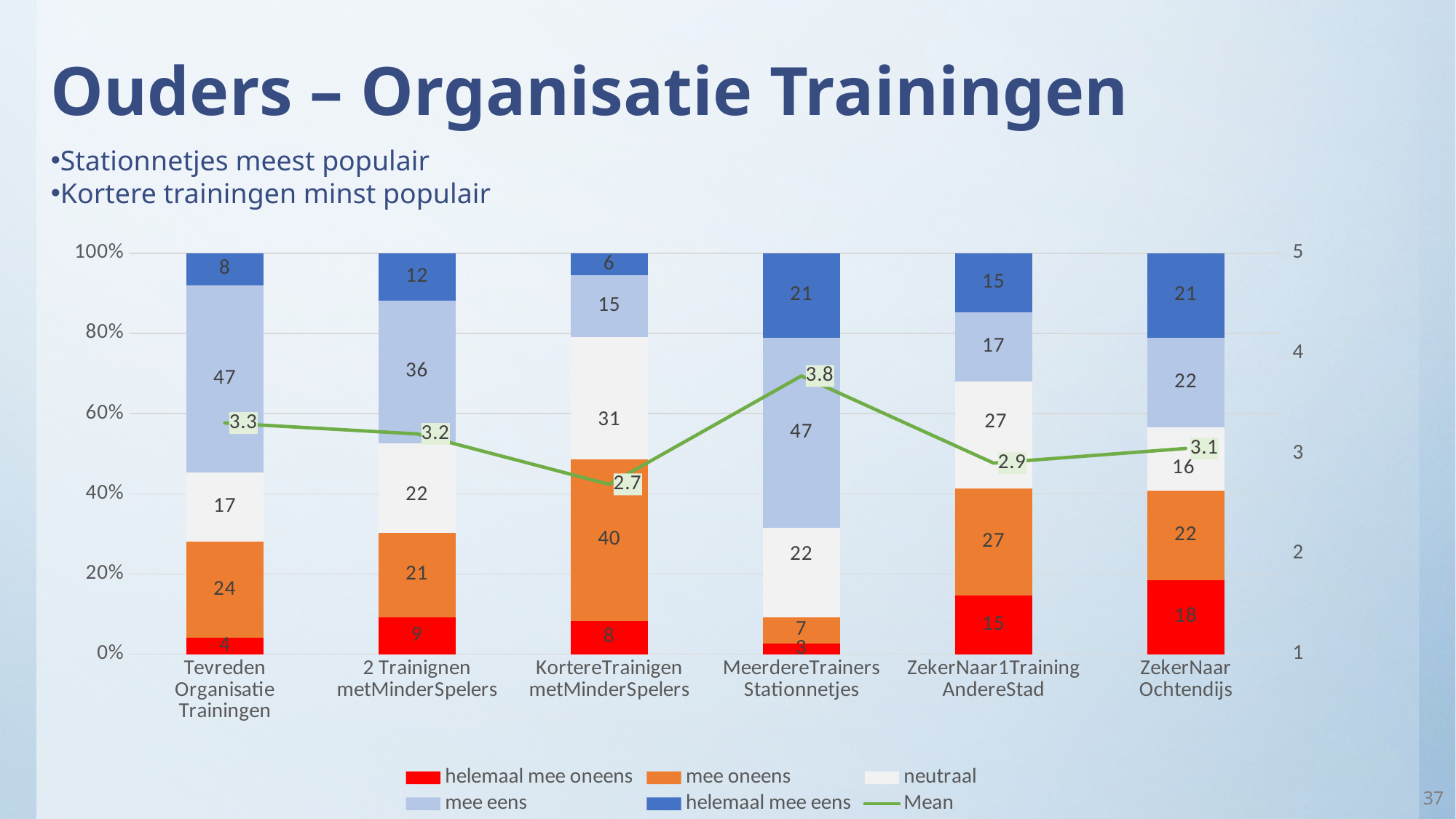
What is the Mean value for MeerdereTrainers Stationnetjes? 3.8 Which is larger: the 'helemaal mee oneens' value for ZekerNaar Ochtendijs or for Tevreden Organisatie Trainingen? ZekerNaar Ochtendijs What kind of chart is shown on the slide? Stacked bar chart with a line How many series does the legend list? 6 What is the 'neutraal' value for ZekerNaar1Training AndereStad? 27 How many categories are shown on the x axis? 6 Which category has the lowest Mean value? KortereTrainigen metMinderSpelers Which legend entry is shown in red? helemaal mee oneens What is the 'helemaal mee eens' value for ZekerNaar Ochtendijs? 21 Which category has the highest Mean value? MeerdereTrainers Stationnetjes What is the difference between the Mean values of MeerdereTrainers Stationnetjes and KortereTrainigen metMinderSpelers? 1.1 What is the 'mee oneens' value for KortereTrainigen metMinderSpelers? 40